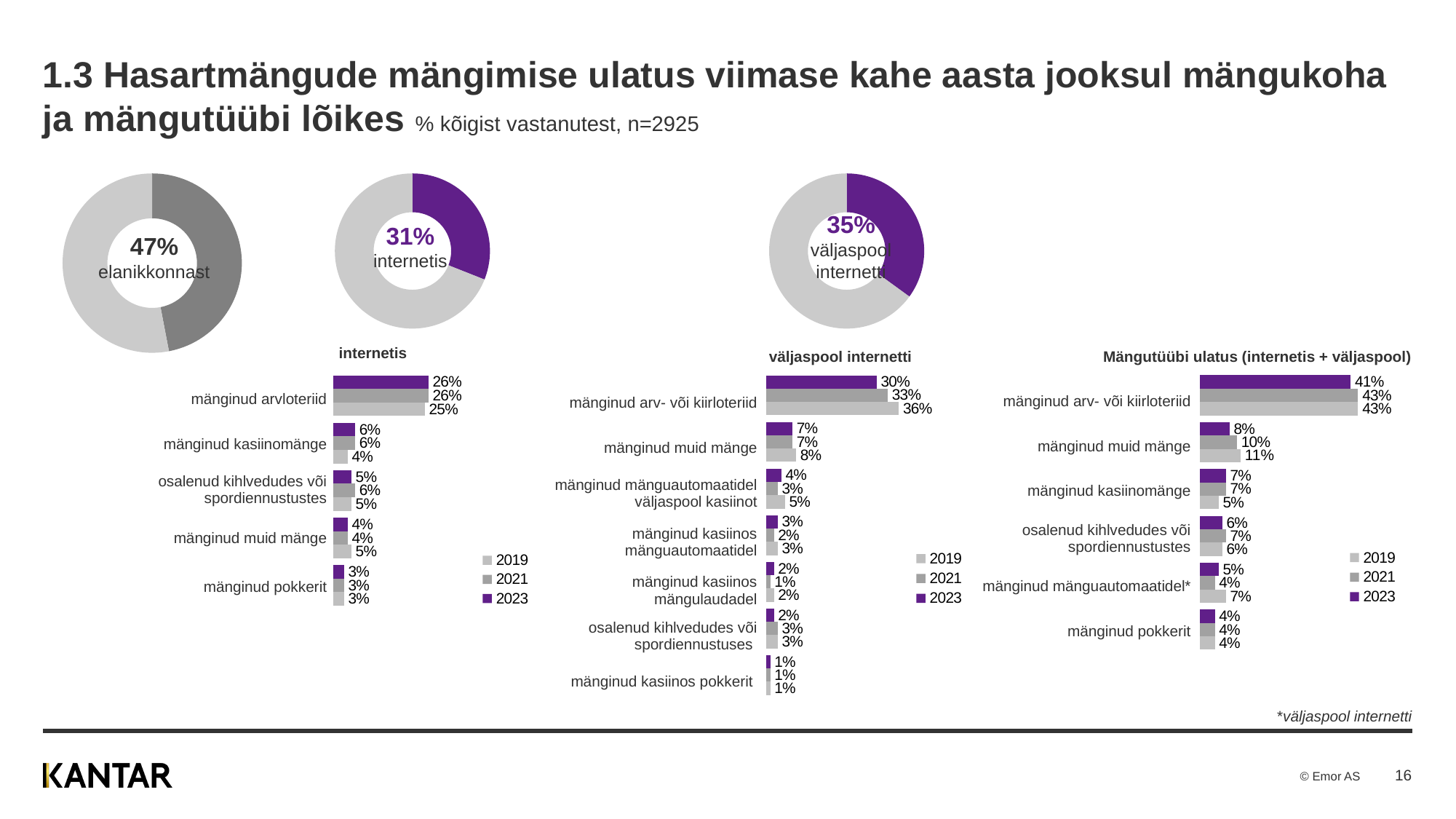
How many categories does the 'väljaspool internetti' bar chart show? 7 What percentage is shown in the centre of the donut chart labelled 'väljaspool internetti'? 35% In the 'väljaspool internetti' bar chart, which category has the lowest 2023 value? mänginud kasiinos pokkerit In the 'väljaspool internetti' bar chart, what is the difference between the 2019 and 2023 values for 'mänginud arv- või kiirloteriid'? 6% In the 'internetis' bar chart, what is the 2023 value for 'mänginud arvloteriid'? 26% What kind of chart is the 'internetis' chart below the donuts? bar chart How many series does the legend of the 'internetis' bar chart list? 3 In the 'Mängutüübi ulatus (internetis + väljaspool)' bar chart, what is the 2021 value for 'mänginud muid mänge'? 10% In the 'Mängutüübi ulatus (internetis + väljaspool)' bar chart, is the 2019 value for 'mänginud mänguautomaatidel*' larger or smaller than the 2023 value? larger What percentage is shown in the centre of the donut chart labelled 'elanikkonnast'? 47% In the 'väljaspool internetti' bar chart, what is the 2019 value for 'mänginud arv- või kiirloteriid'? 36% In the 'Mängutüübi ulatus (internetis + väljaspool)' bar chart, which category has the highest 2023 value? mänginud arv- või kiirloteriid